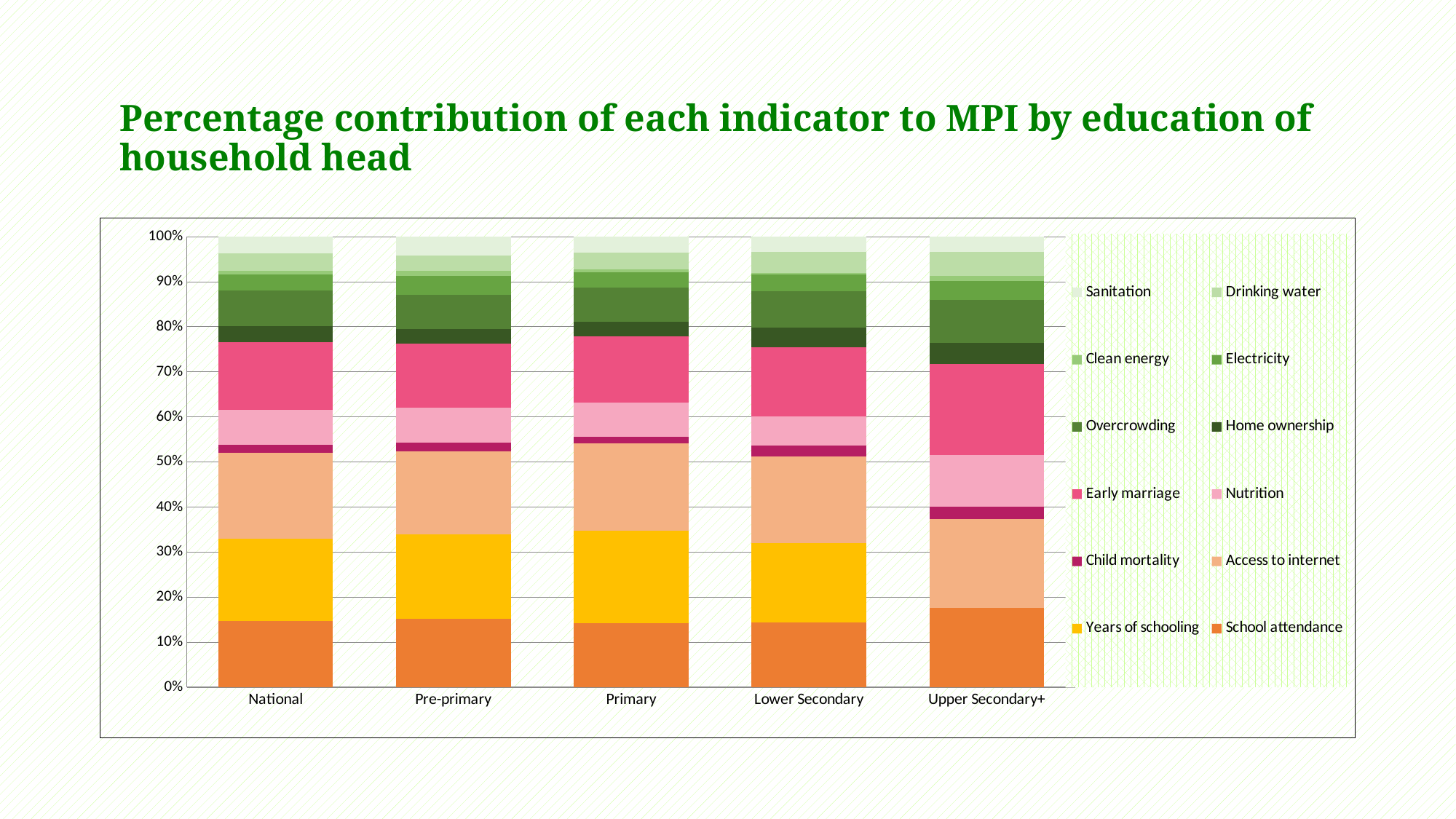
Is the Early marriage contribution larger for National or for Upper Secondary+? Upper Secondary+ What kind of chart is shown on the slide? Stacked bar chart Which education category has the largest School attendance contribution? Upper Secondary+ Is the School attendance contribution for National greater or less than 20%? less Which indicator is shown in yellow in the legend? Years of schooling What is the label of the last category on the x axis? Upper Secondary+ What does each stacked bar total, according to the y axis? 100% How many education categories are shown along the x axis? 5 How many indicators (series) does the legend list? 12 Which education category has the largest Early marriage contribution? Upper Secondary+ Is the School attendance contribution for Upper Secondary+ greater or less than 10%? greater What is the title of the chart? Percentage contribution of each indicator to MPI by education of household head